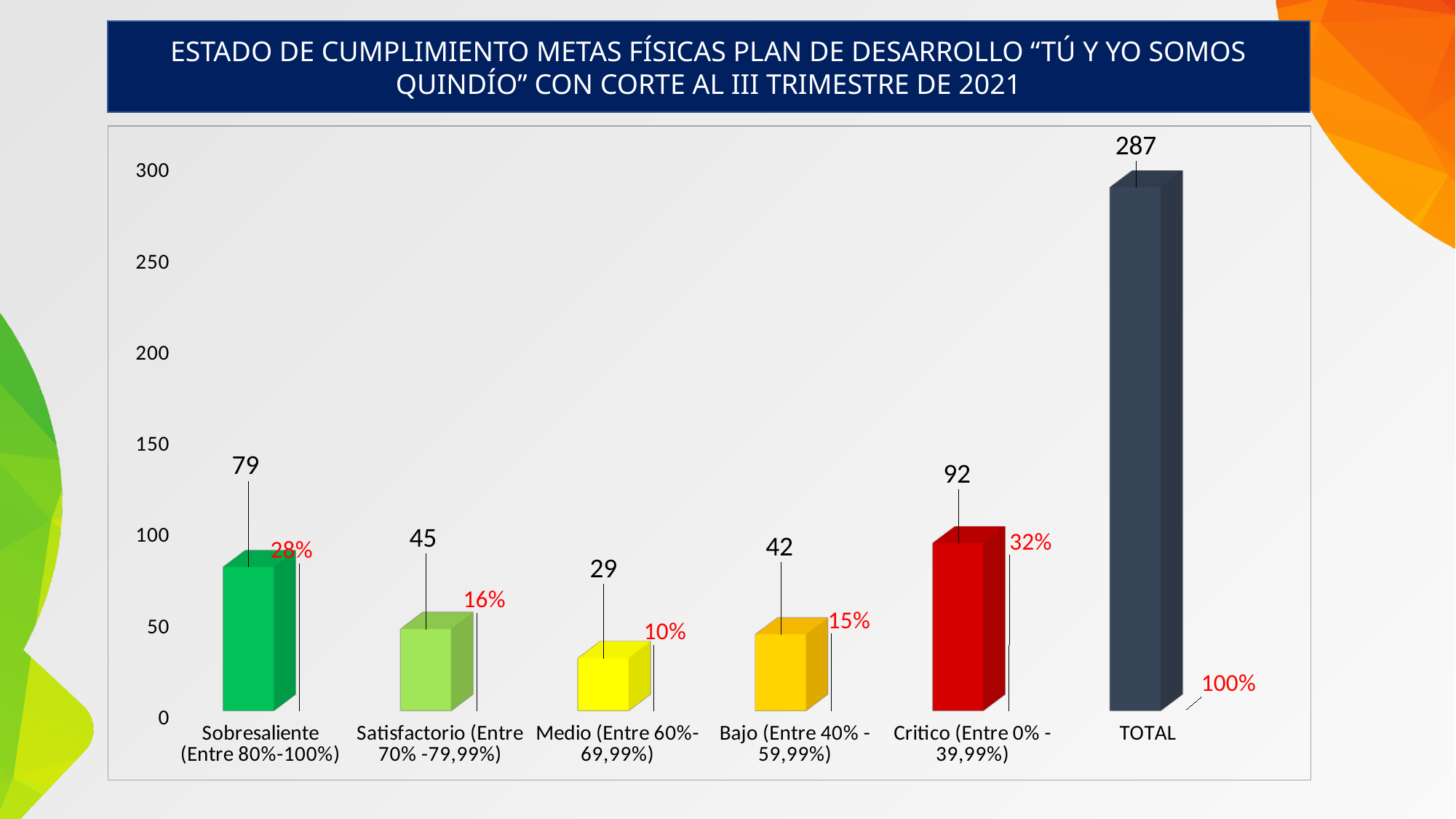
What kind of chart is shown on the slide? Bar chart What is the value for Sobresaliente (Entre 80%-100%)? 79 Which category has the lowest value? Medio (Entre 60%-69,99%) What is the value for Medio (Entre 60%-69,99%)? 29 What colour is the bar for Critico (Entre 0% - 39,99%)? Red What is the value for Critico (Entre 0% - 39,99%)? 92 How many categories are shown on the x axis, including TOTAL? 6 Which is larger, the value for Satisfactorio or the value for Bajo? Satisfactorio Excluding TOTAL, which category has the highest value? Critico (Entre 0% - 39,99%) What is the value for TOTAL? 287 What is the difference between the values for Critico and Sobresaliente? 13 What percentage is shown for Satisfactorio (Entre 70% -79,99%)? 16%